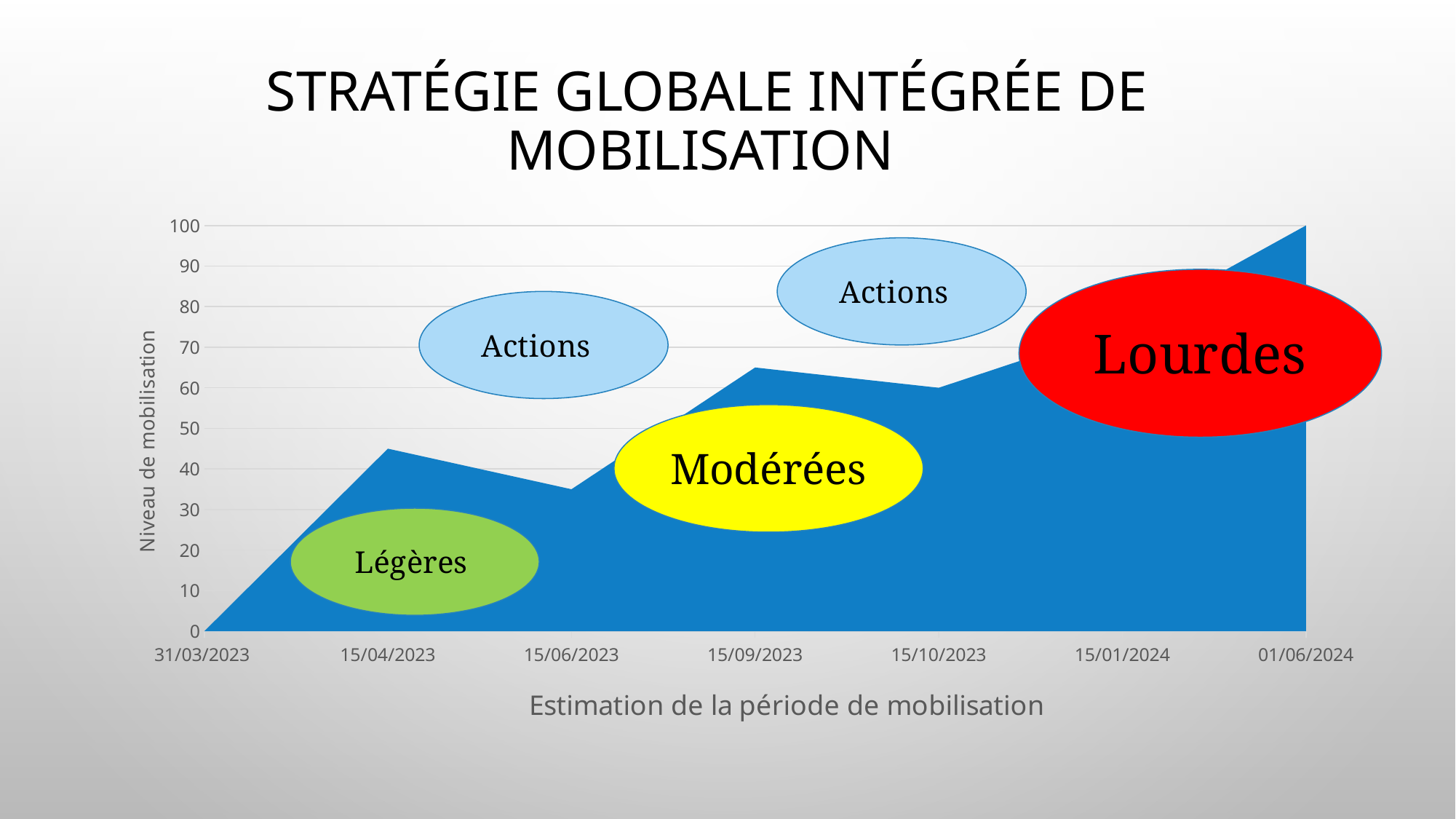
Is the value for 15/09/2023 greater or less than 60? greater Is the value for 15/04/2023 greater or less than 40? greater At which date does the chart have its lowest value? 31/03/2023 What kind of chart is shown on the slide? Area chart What is the value of the chart at 01/06/2024? 100 What is the title of the y axis of the chart? Niveau de mobilisation What is the value of the chart at 31/03/2023? 0 Is the value for 15/06/2023 greater or less than 40? less At which date does the chart reach its highest value? 01/06/2024 Which is larger, the value at 15/04/2023 or the value at 15/06/2023? 15/04/2023 Overall, do the values rise or fall from 31/03/2023 to 01/06/2024? Rise How many dates are shown on the x axis of the chart? 7